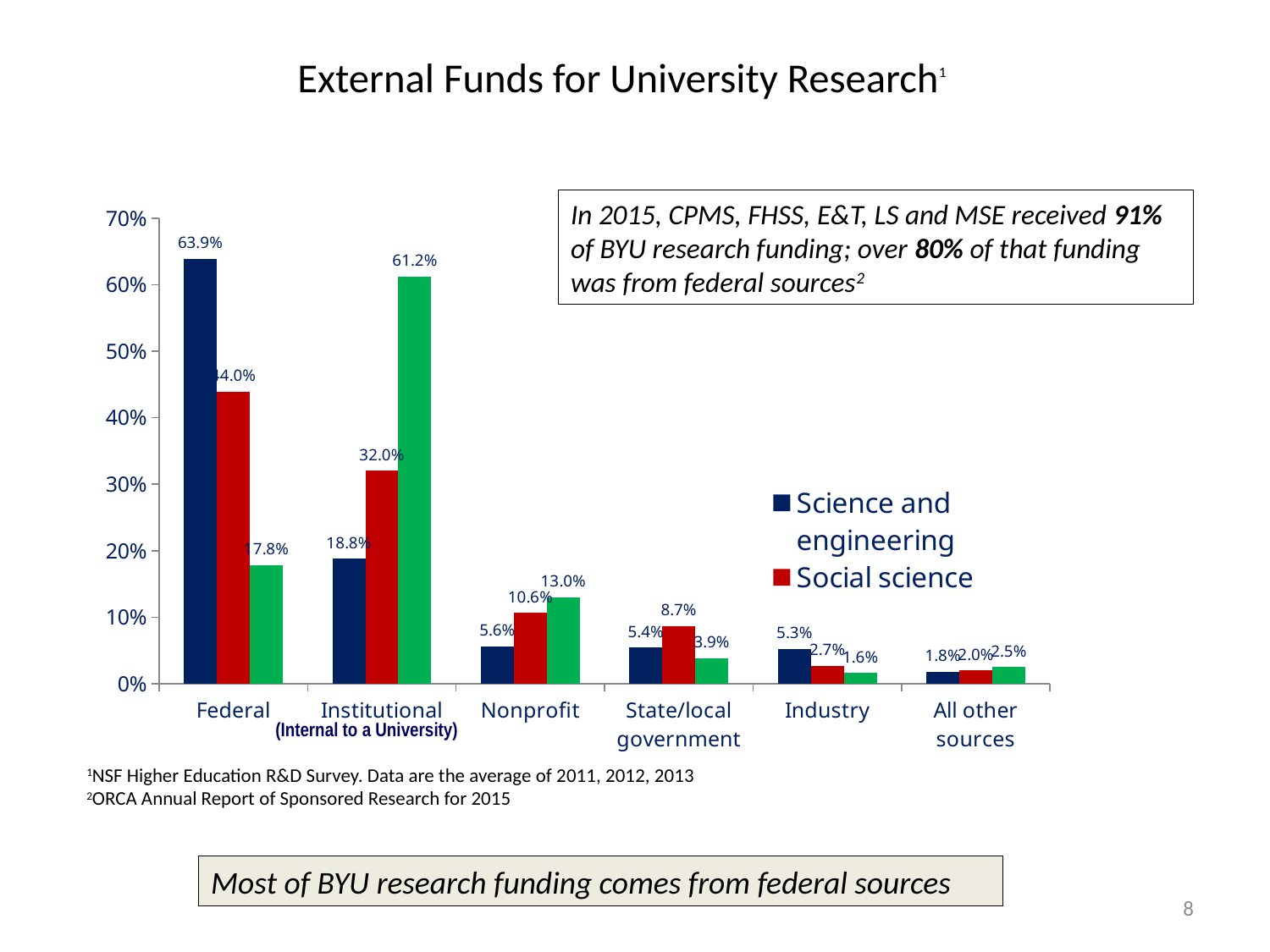
Do the Science and engineering values rise or fall from left to right across the categories? fall Which category has the lowest Science and engineering value? All other sources What is the Social science value for State/local government? 8.7% Which category has the highest Science and engineering value? Federal For Nonprofit, which is larger: the Science and engineering value or the Social science value? Social science Is the Science and engineering value for Federal greater or less than 60%? greater What is the Social science value for Institutional? 32.0% What is the Science and engineering value for Nonprofit? 5.6% What is the difference between the Science and engineering values for Federal and Institutional? 45.1 percentage points What is the Science and engineering value for Federal? 63.9% How many series does the legend list? 2 How many funding source categories are shown on the x axis? 6